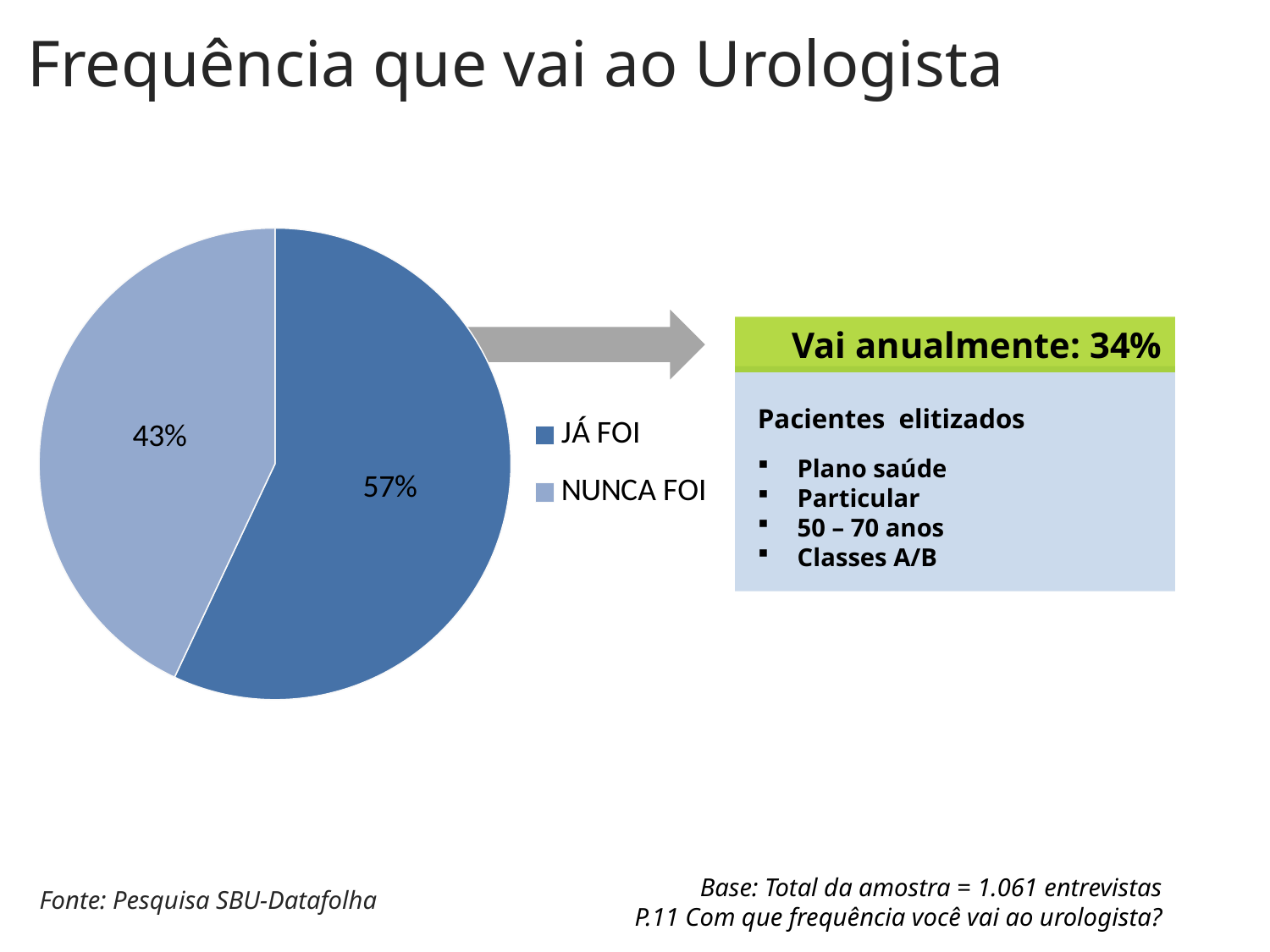
Which legend entry is shown in the darker blue colour? JÁ FOI What percentage of the pie is labelled JÁ FOI? 57% Which slice of the pie is the largest? JÁ FOI How many slices does the pie chart have? 2 Which slice of the pie is the smallest? NUNCA FOI What is the difference in percentage points between the JÁ FOI and NUNCA FOI slices? 14 What percentage of the pie is labelled NUNCA FOI? 43% What share of the pie does the NUNCA FOI slice represent? 43% Which is larger, the JÁ FOI slice or the NUNCA FOI slice? JÁ FOI What is the title of the slide containing the pie chart? Frequência que vai ao Urologista How many entries does the legend list? 2 What type of chart is shown on the slide? pie chart